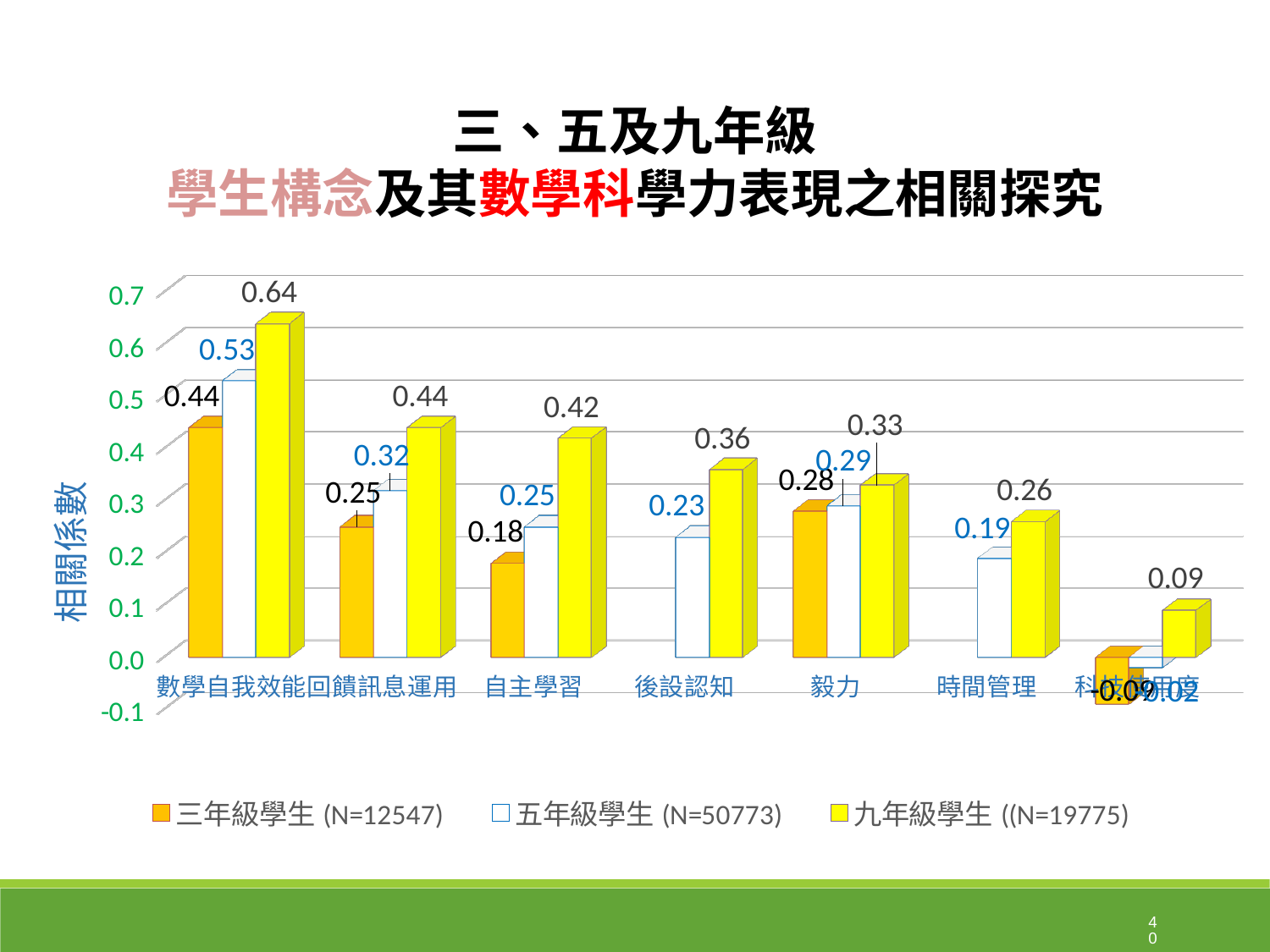
What is the value for 九年級學生 in the 時間管理 category? 0.26 What is the title of the y axis? 相關係數 How many series does the legend list? 3 Do the 九年級學生 values rise or fall moving from left to right along the x axis? fall What is the value for 九年級學生 in the 數學自我效能 category? 0.64 What is the value for 五年級學生 in the 自主學習 category? 0.25 Which is larger: the 九年級學生 value for 後設認知 or the 九年級學生 value for 毅力? 後設認知 What is the value for 三年級學生 in the 毅力 category? 0.28 How many categories are shown along the x axis? 7 Which category has the highest value for 九年級學生? 數學自我效能 What kind of chart is shown on the slide? bar chart What is the difference between the 九年級學生 and 三年級學生 values in the 數學自我效能 category? 0.20